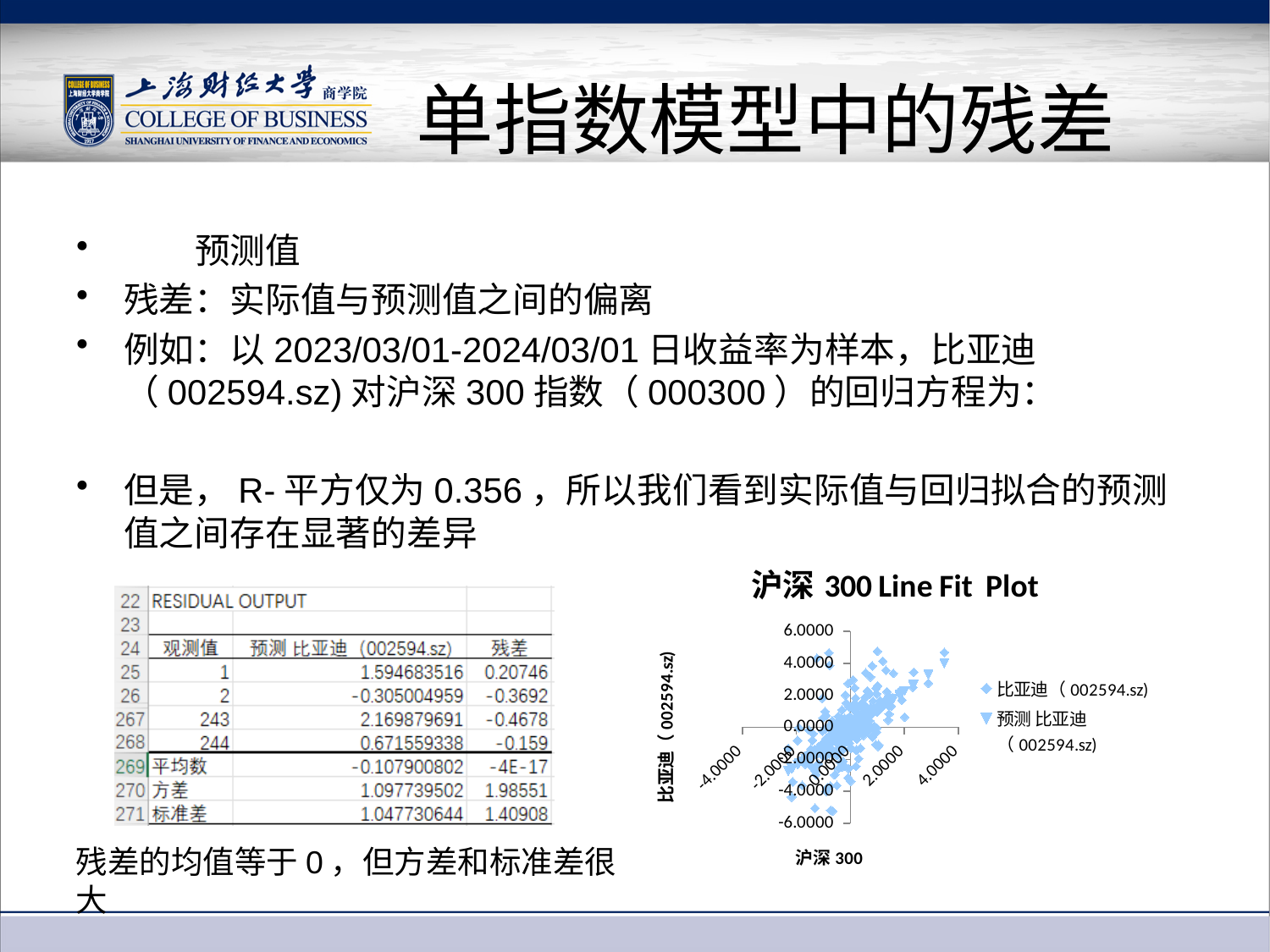
What is the lowest tick value shown on the y axis of the chart? -6.0000 In the chart, do the 比亚迪（002594.sz) values generally rise or fall as 沪深 300 increases? rise What kind of chart is shown on the slide? scatter chart How many series does the chart's legend list? 2 What is the highest tick value shown on the x axis of the chart? 4.0000 What is the highest tick value shown on the y axis of the chart? 6.0000 What is the title of the chart on the slide? 沪深 300 Line Fit Plot What is the label of the x axis of the chart? 沪深 300